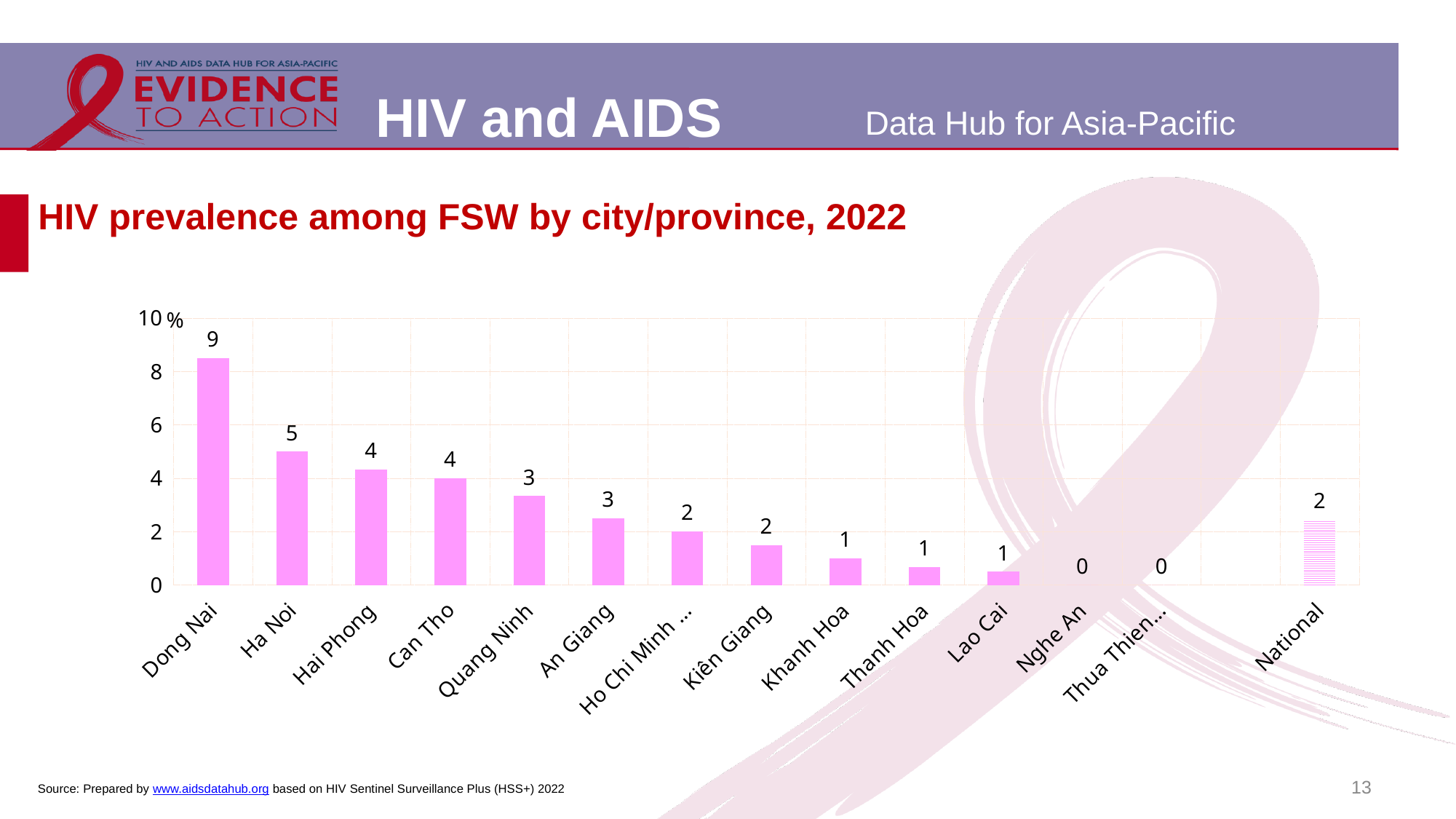
Which has the larger value, Ha Noi or Hai Phong? Ha Noi Do the values for the cities/provinces rise or fall from left to right, before the National bar? Fall What is the value labelled for Quang Ninh? 3 Is the value for Dong Nai greater or less than 8? greater What is the HIV prevalence among FSW in Dong Nai? 9 Which city/province has the highest HIV prevalence among FSW? Dong Nai What value is shown for Ha Noi? 5 What is the difference between the labelled values for Dong Nai and Ha Noi? 4 What value is shown for Nghe An? 0 How many categories are shown on the x axis? 14 What kind of chart is shown on the slide? Bar chart What is the National value shown on the chart? 2